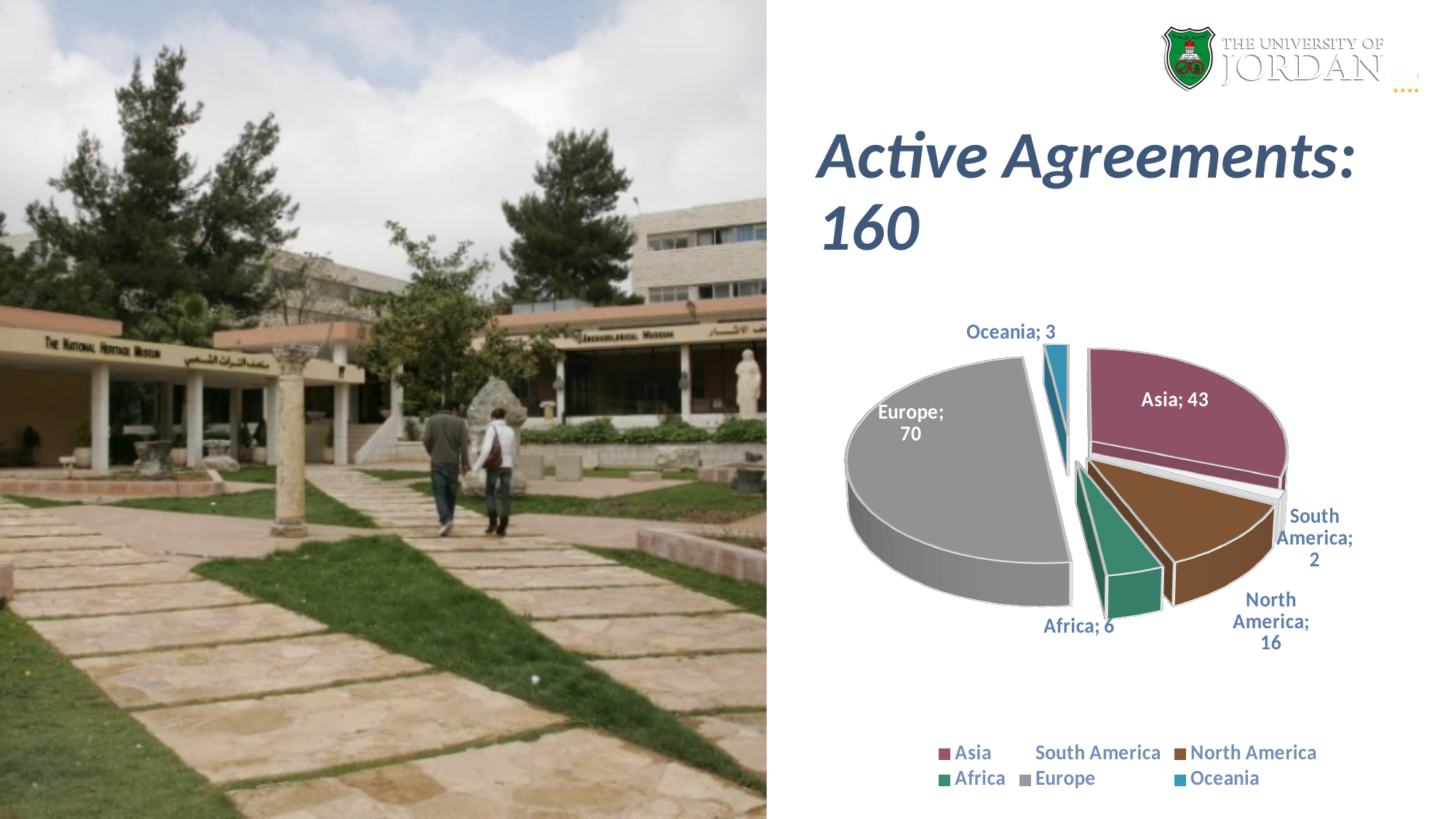
What type of chart is shown on the slide? pie chart Which region has the smallest slice in the pie chart? South America Which has a larger value, North America or Africa? North America How many regions are shown in the pie chart? 6 What is the difference between the values for Europe and Asia? 27 How many entries does the legend list? 6 How many active agreements does the pie chart show for Asia? 43 What is the difference between the values for Africa and South America? 4 Which region has the largest slice in the pie chart? Europe What value is shown for Oceania in the pie chart? 3 What value is shown for North America in the pie chart? 16 What value is shown for Europe in the pie chart? 70